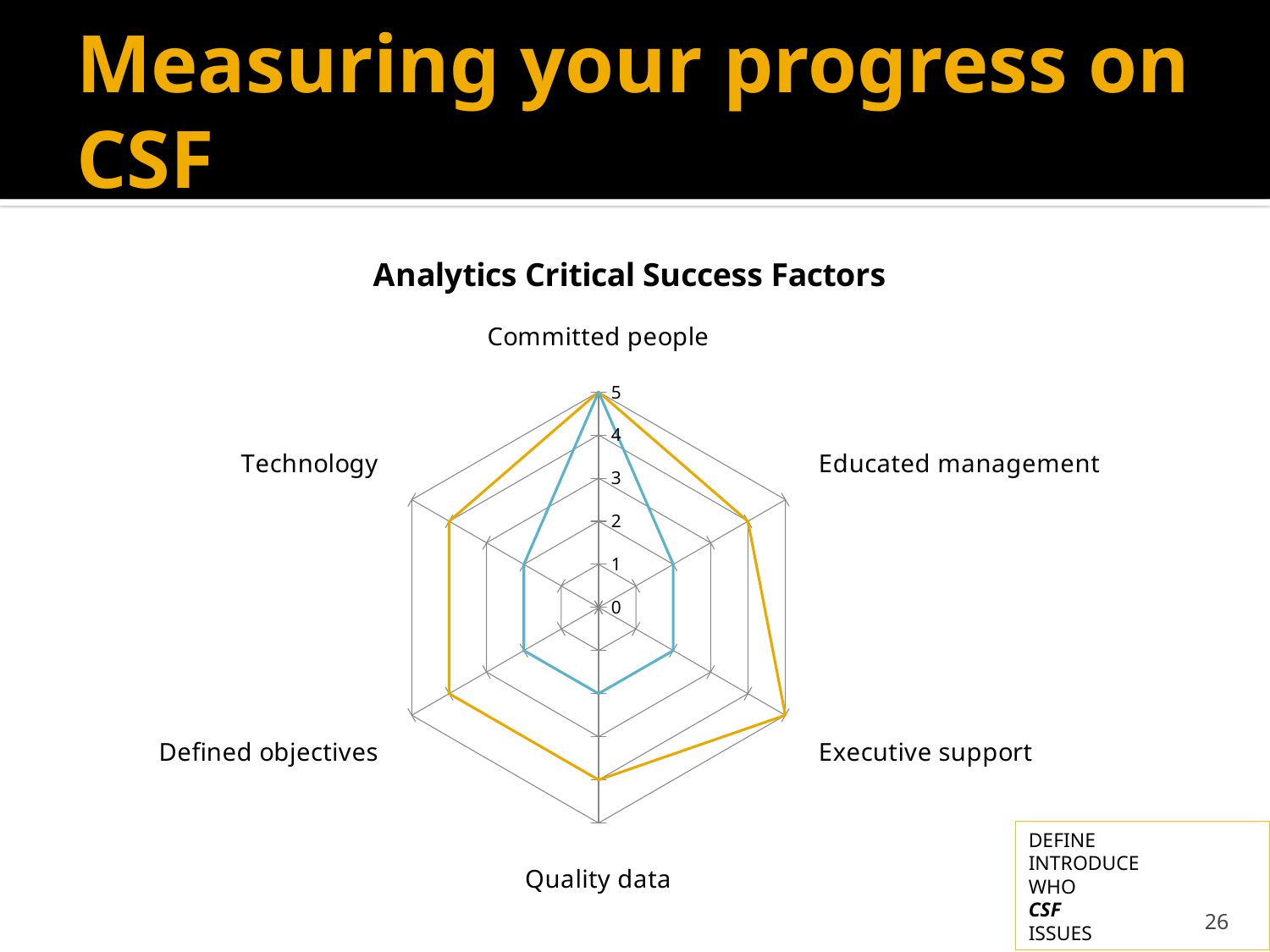
How many categories (axes) does the radar chart have? 6 What is the title of the chart? Analytics Critical Success Factors Is the orange series value for Educated management greater or less than 3? greater What is the maximum value shown on the radar chart's axis scale? 5 How many data series (lines) are plotted on the radar chart? 2 What value does the blue series have for Technology? 2 Is the blue series value for Quality data greater or less than 3? less On which category do the blue and orange series have the same value? Committed people What value does the blue series reach for Committed people? 5 What value does the orange series reach for Executive support? 5 What kind of chart is shown on the slide? Radar chart For Defined objectives, which series has the larger value, the orange or the blue? Orange